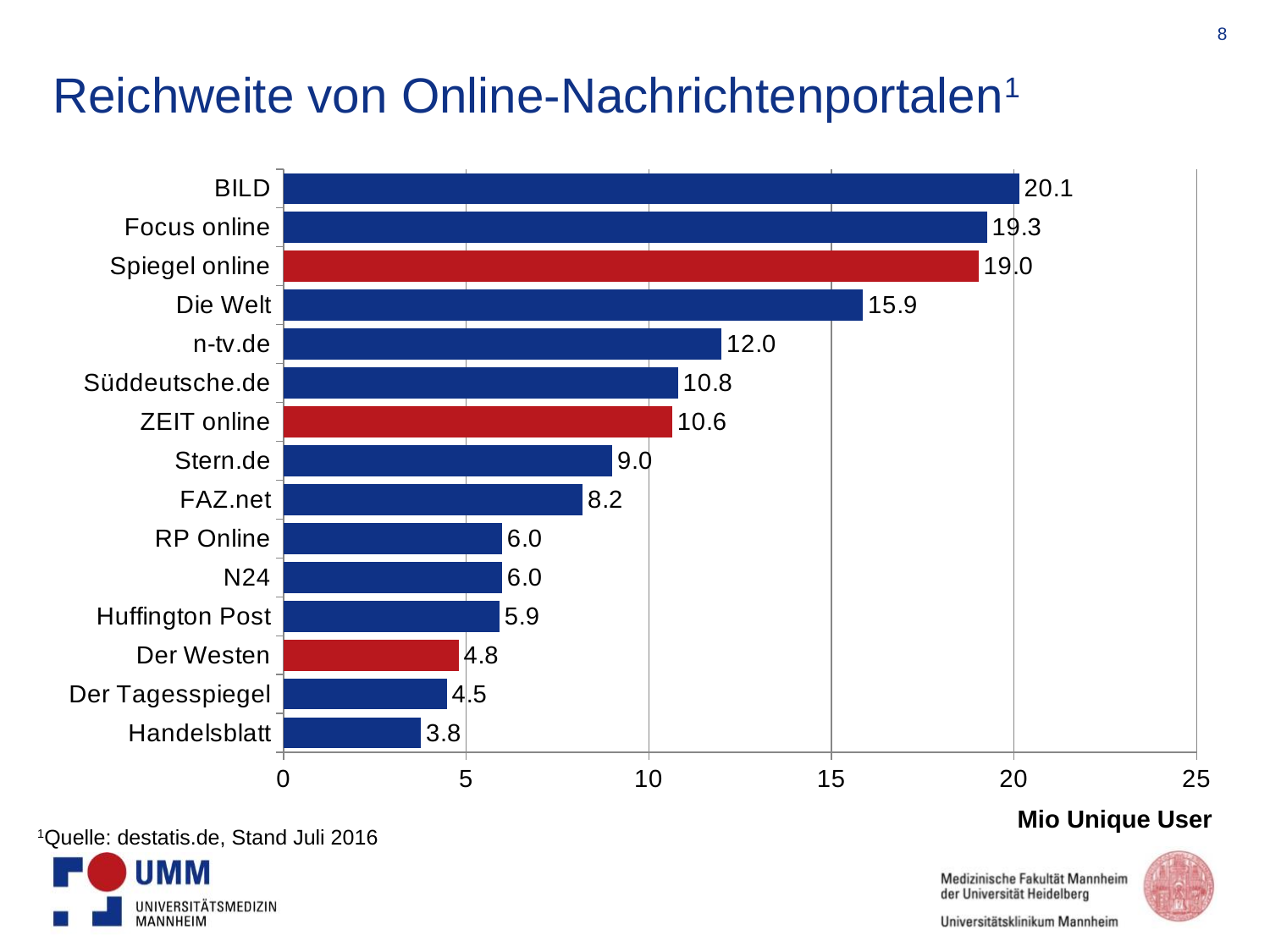
What is the value for Süddeutsche.de? 10.8 What is the difference between the values for n-tv.de and Stern.de? 3.0 What is the difference between the values for BILD and Die Welt? 4.2 Which portal has the highest value? BILD What is the value for Spiegel online? 19.0 What kind of chart is shown on the slide? bar chart Which is larger, the value for FAZ.net or the value for Der Westen? FAZ.net What is the value for Huffington Post? 5.9 Which portal has the lowest value? Handelsblatt What unit label is shown below the x axis of the chart? Mio Unique User How many portals are shown in the chart? 15 Is the value for Die Welt greater or less than 15? greater